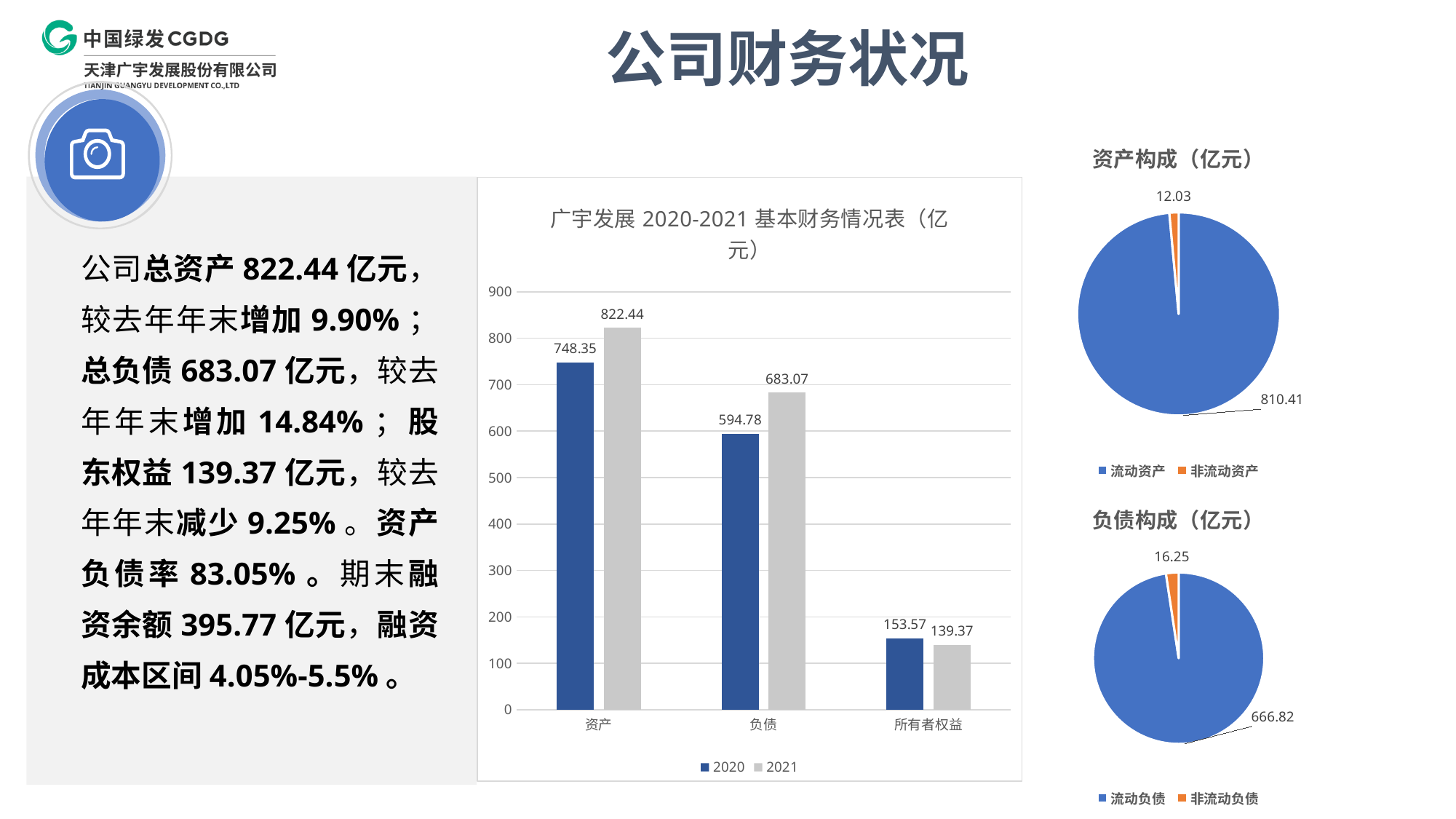
In the bar chart titled 广宇发展 2020-2021 基本财务情况表（亿元）, what is the value for 资产 in 2021? 822.44 In the bar chart titled 广宇发展 2020-2021 基本财务情况表（亿元）, what is the value for 负债 in 2020? 594.78 In the bar chart titled 广宇发展 2020-2021 基本财务情况表（亿元）, what is the difference between the 2021 and 2020 values for 资产? 74.09 What kind of chart is the one titled 广宇发展 2020-2021 基本财务情况表（亿元）? bar chart In the pie chart titled 负债构成（亿元）, which slice is larger: 流动负债 or 非流动负债? 流动负债 In the bar chart titled 广宇发展 2020-2021 基本财务情况表（亿元）, how many categories are shown on the x axis? 3 In the bar chart titled 广宇发展 2020-2021 基本财务情况表（亿元）, which is larger for 所有者权益: the 2020 value or the 2021 value? 2020 In the bar chart titled 广宇发展 2020-2021 基本财务情况表（亿元）, how many series does the legend list? 2 In the pie chart titled 资产构成（亿元）, what is the value for 非流动资产? 12.03 In the bar chart titled 广宇发展 2020-2021 基本财务情况表（亿元）, which category has the lowest value in 2020? 所有者权益 In the pie chart titled 负债构成（亿元）, what is the value for 流动负债? 666.82 In the bar chart titled 广宇发展 2020-2021 基本财务情况表（亿元）, what is the value for 所有者权益 in 2021? 139.37